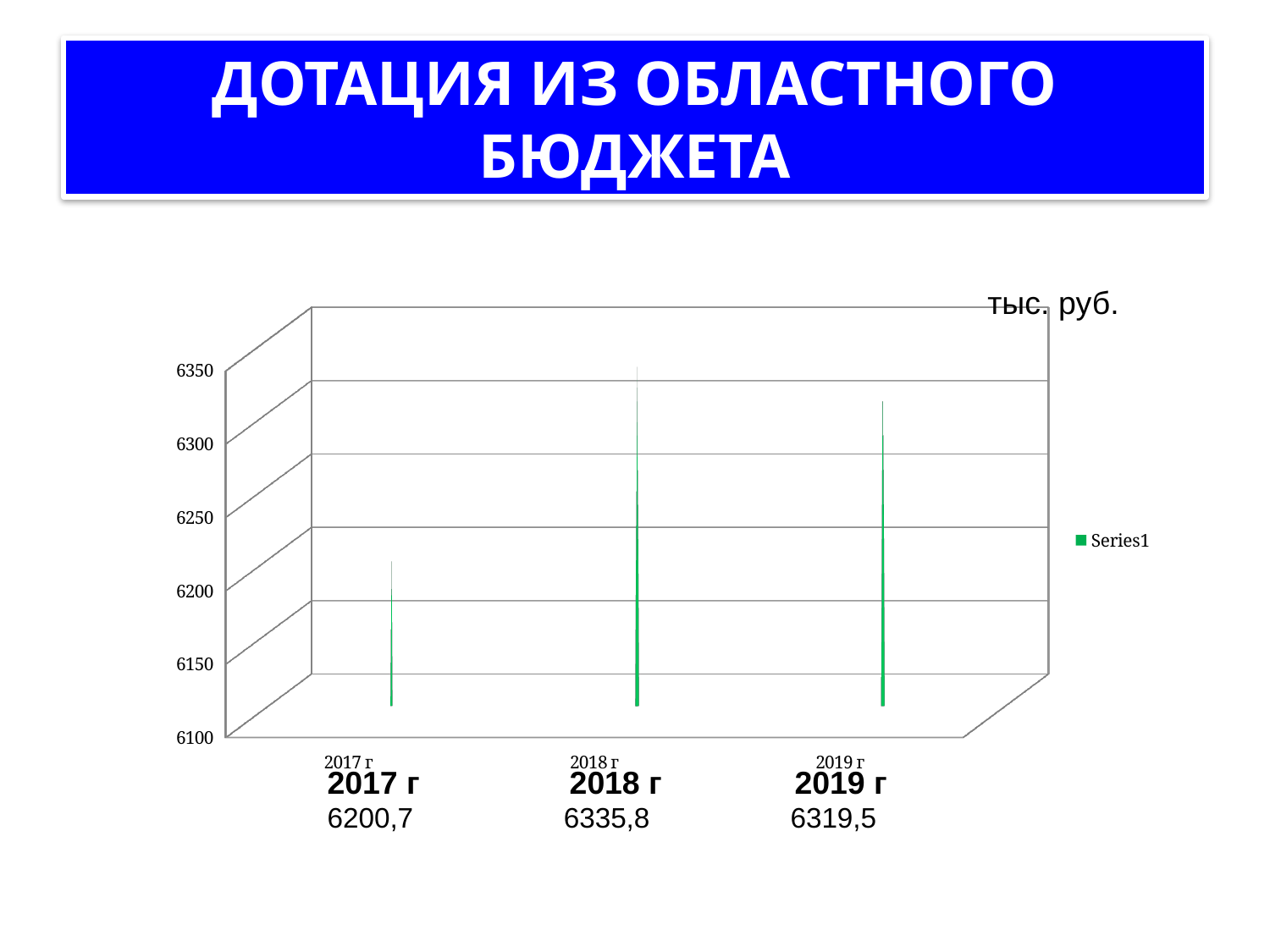
How many series does the legend list? 1 Which year has the highest value? 2018 г What is the difference between the values for 2018 г and 2017 г? 135,1 What is the value for 2018 г? 6335,8 What kind of chart is shown on the slide? bar chart What is the difference between the values for 2018 г and 2019 г? 16,3 Which is larger, the value for 2019 г or the value for 2017 г? 2019 г Is the value for 2017 г greater or less than 6250? less What is the value for 2017 г? 6200,7 Which year has the lowest value? 2017 г How many years are shown on the x axis? 3 What is the value for 2019 г? 6319,5